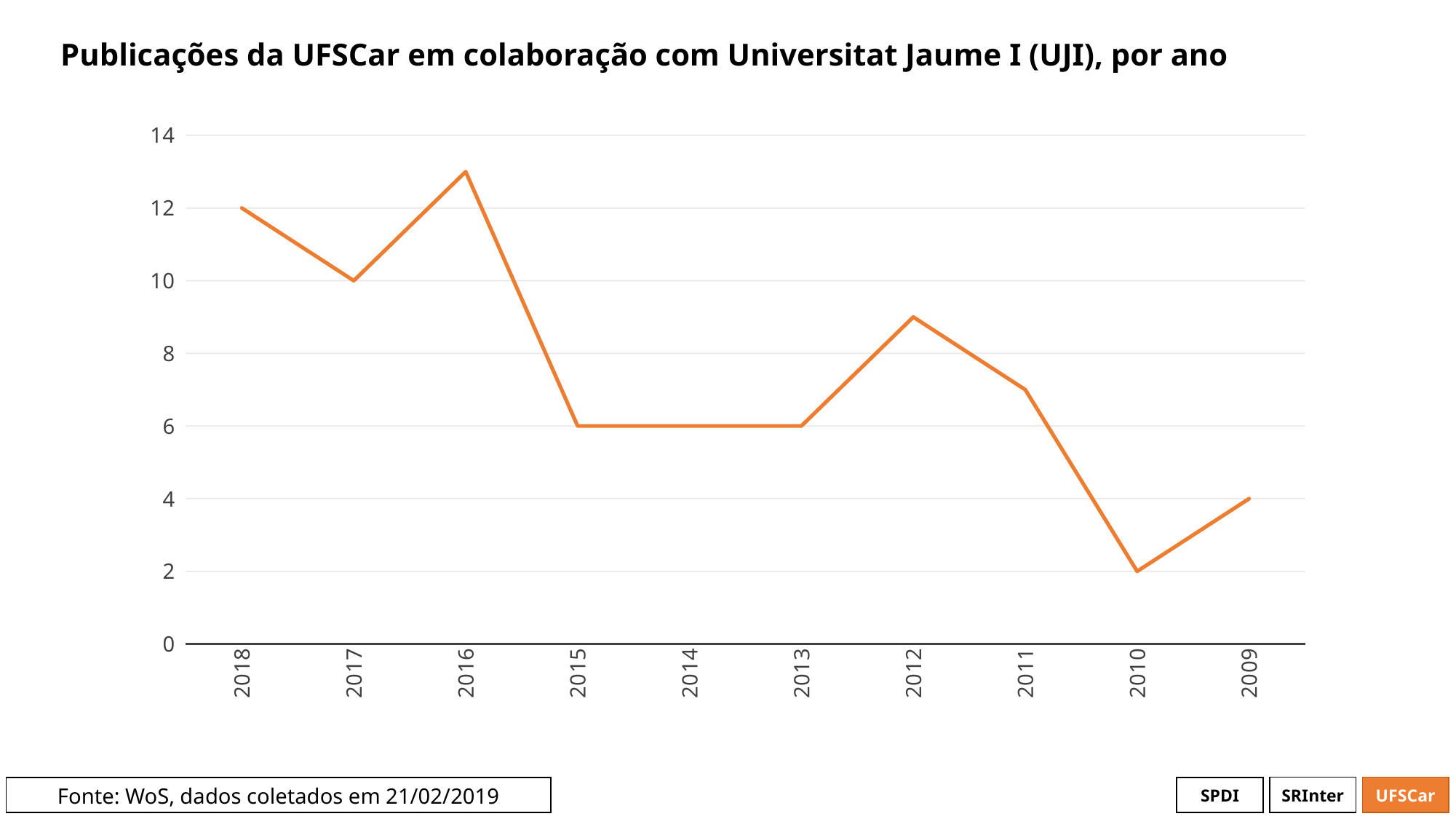
Which is larger, the value for 2015 or the value for 2009? 2015 What kind of chart is shown on the slide? line chart What is the value for 2009? 4 Is the value for 2016 greater or less than 12? greater What is the value for 2017? 10 Which year has the lowest value? 2010 What is the difference between the values for 2018 and 2010? 10 What is the value for 2010? 2 Which year has the highest value? 2016 What is the value for 2018? 12 Is the value for 2012 greater or less than 8? greater How many years are plotted on the x axis? 10